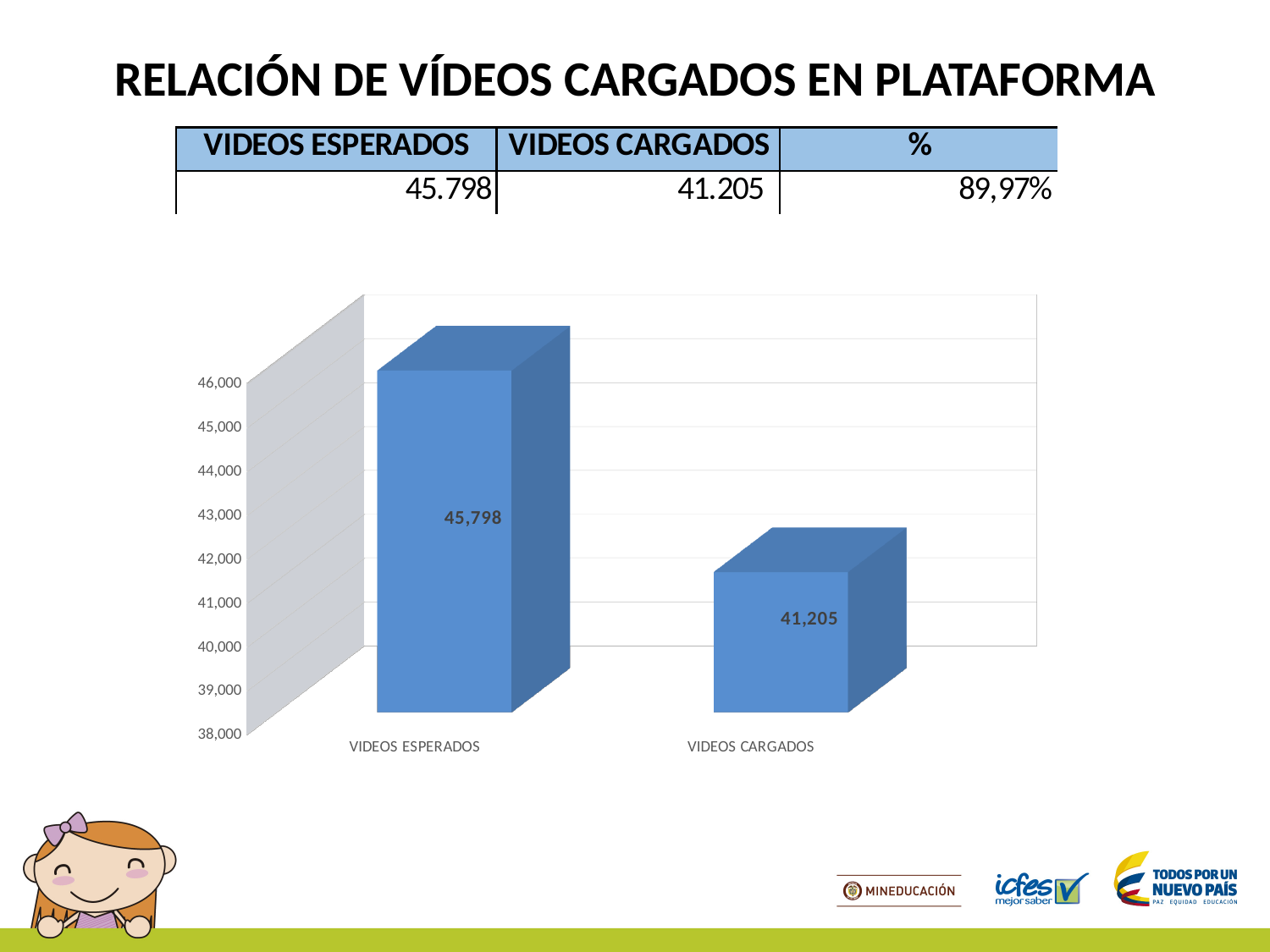
How many categories are shown in the chart? 2 Which category has the highest value? VIDEOS ESPERADOS What is the difference between VIDEOS ESPERADOS and VIDEOS CARGADOS? 4,593 What is the value for VIDEOS ESPERADOS? 45,798 What is the value for VIDEOS CARGADOS? 41,205 What colour are the bars in the chart? blue What is the lowest value shown on the vertical axis of the chart? 38,000 Which is larger, VIDEOS ESPERADOS or VIDEOS CARGADOS? VIDEOS ESPERADOS Which category has the lowest value? VIDEOS CARGADOS Is the value for VIDEOS ESPERADOS greater or less than 45,000? greater What kind of chart is shown on the slide? bar chart Is the value for VIDEOS CARGADOS greater or less than 42,000? less